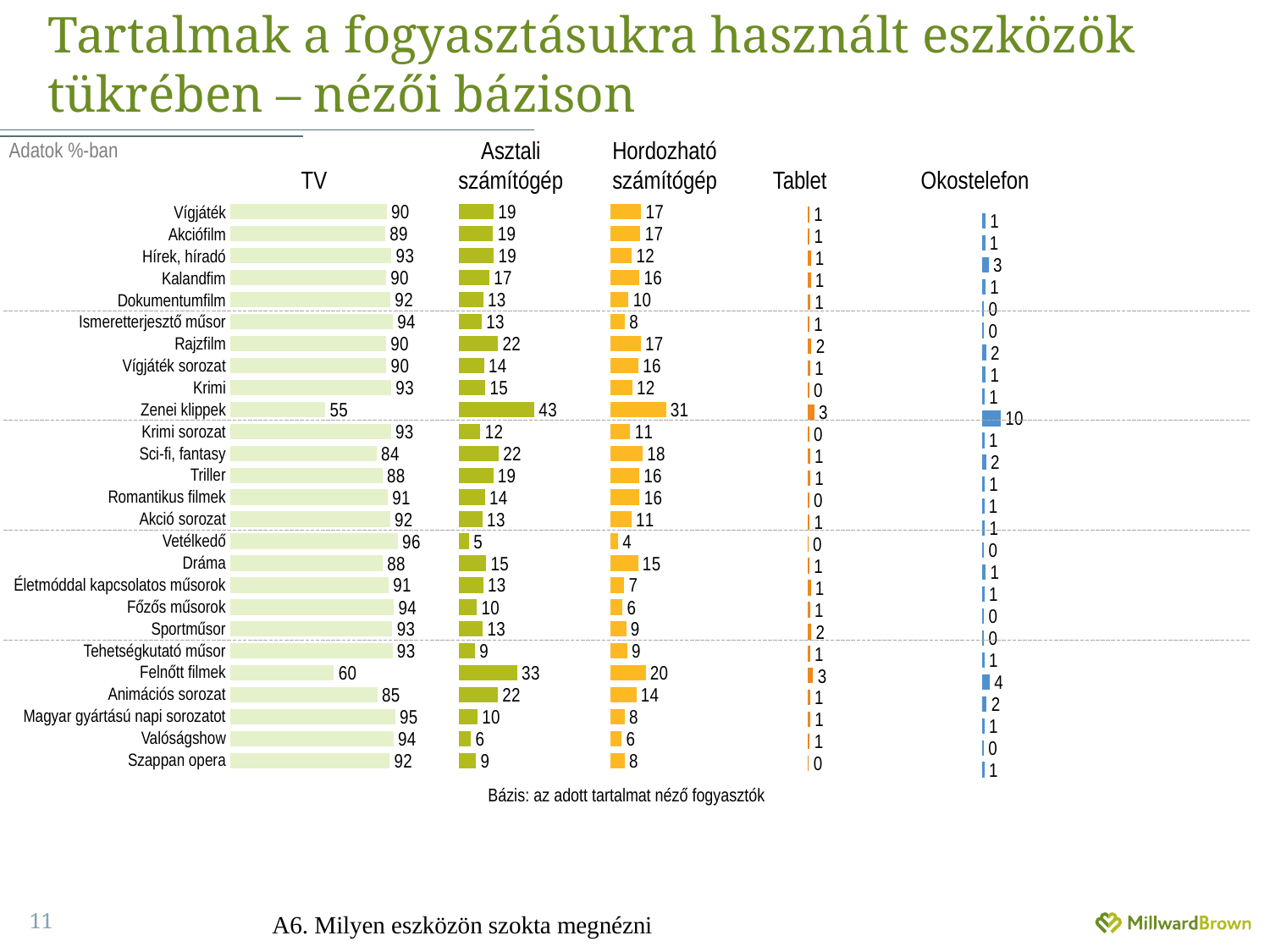
In the Hordozható számítógép chart, which is larger, the value for Sci-fi, fantasy or the value for Triller? Sci-fi, fantasy In the TV chart, what is the value for Zenei klippek? 55 In the Asztali számítógép chart, what is the value for Felnőtt filmek? 33 In the TV chart, what is the difference between the values for Vetélkedő and Zenei klippek? 41 How many categories are listed in the TV chart? 26 In the TV chart, which category has the lowest value? Zenei klippek What kind of chart is the Tablet chart? Bar chart In the Asztali számítógép chart, which category has the highest value? Zenei klippek In the Hordozható számítógép chart, what is the value for Dráma? 15 In the Okostelefon chart, what is the value for Zenei klippek? 10 In the Hordozható számítógép chart, which category has the lowest value? Vetélkedő In the TV chart, which category has the highest value? Vetélkedő